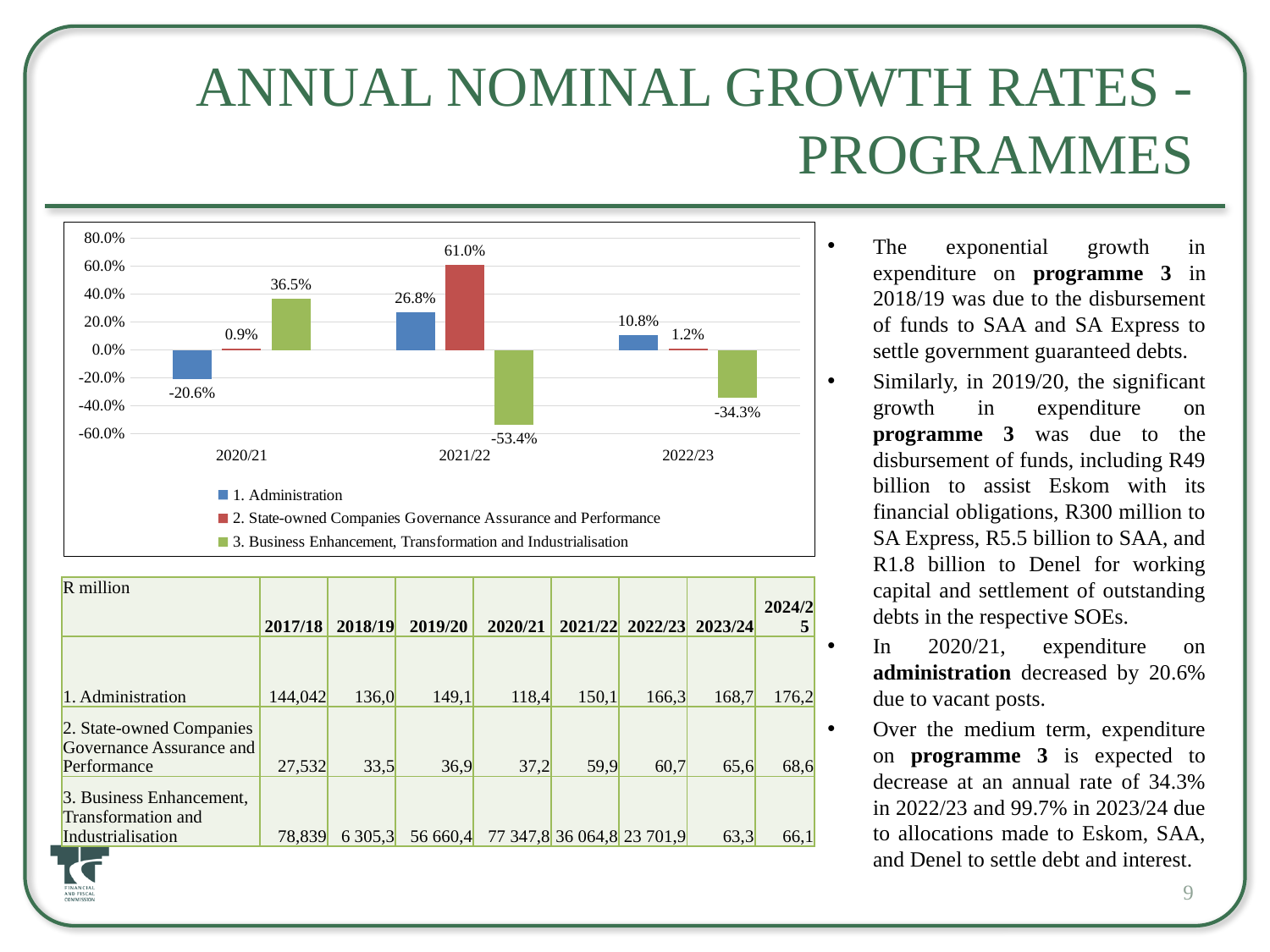
What is the value for 3. Business Enhancement, Transformation and Industrialisation in 2022/23? -34.3% Which is larger in 2022/23: the value for 1. Administration or for 2. State-owned Companies Governance Assurance and Performance? 1. Administration What kind of chart is shown on the slide? Bar chart In which year does 1. Administration have its highest value? 2021/22 How many series does the chart legend list? 3 What is the value for 1. Administration in 2020/21? -20.6% How many years are shown on the x axis of the chart? 3 Does the value for 2. State-owned Companies Governance Assurance and Performance rise or fall from 2021/22 to 2022/23? Fall What is the difference between the 2021/22 values for 2. State-owned Companies Governance Assurance and Performance and 1. Administration? 34.2 percentage points What is the value for 3. Business Enhancement, Transformation and Industrialisation in 2020/21? 36.5% In which year does 3. Business Enhancement, Transformation and Industrialisation have its lowest value? 2021/22 What is the value for 2. State-owned Companies Governance Assurance and Performance in 2021/22? 61.0%